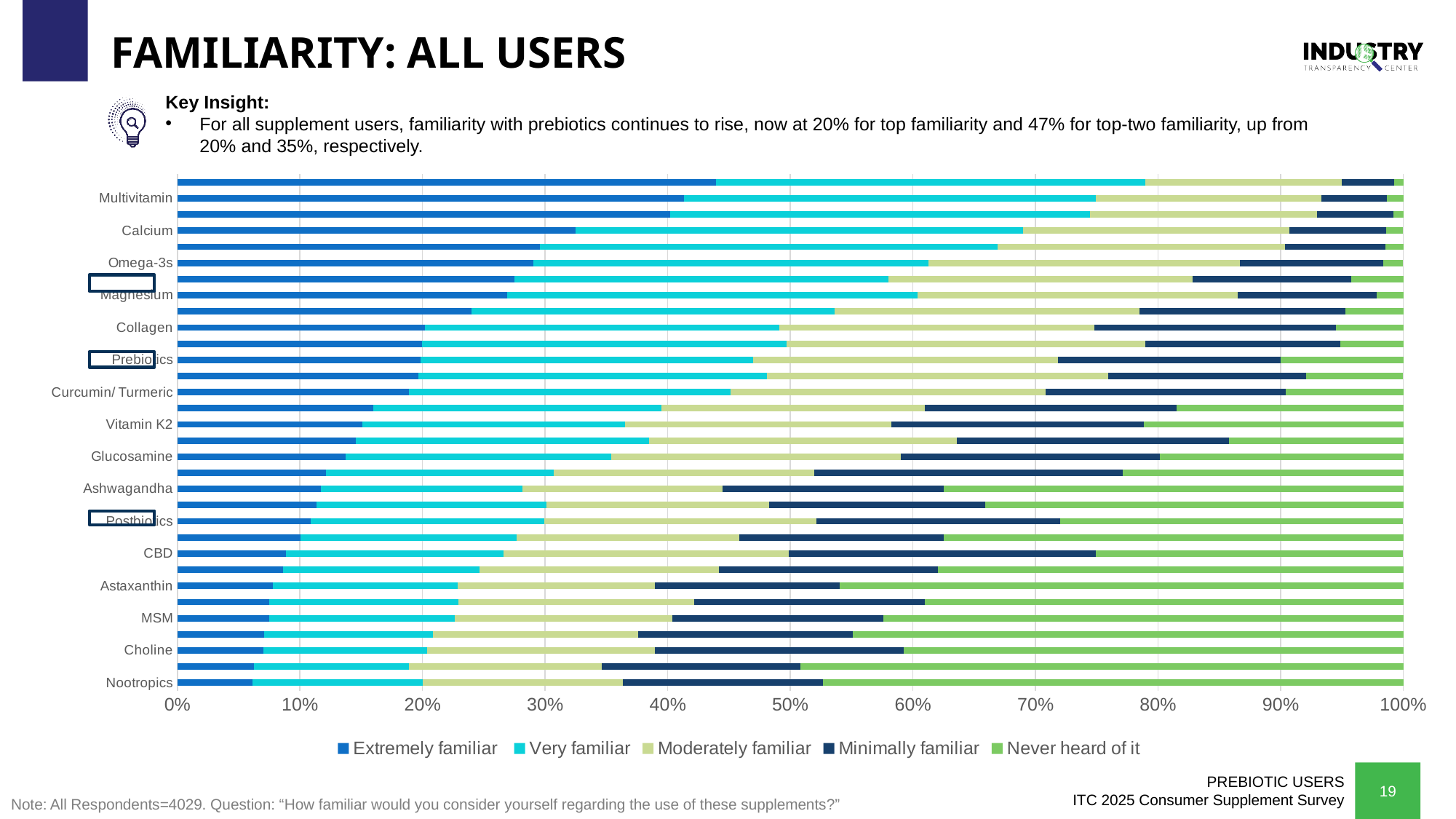
Which supplement has the lowest 'Extremely familiar' share? Nootropics Is the 'Extremely familiar' value for Prebiotics greater or less than 30%? less Which has a larger 'Never heard of it' share, Nootropics or Multivitamin? Nootropics What kind of chart is shown on the slide? Stacked bar chart Moving down the chart from Multivitamin to Nootropics, does the 'Extremely familiar' share rise or fall? Fall What is the title of the slide containing the chart? FAMILIARITY: ALL USERS Is the 'Extremely familiar' value for Multivitamin greater or less than 30%? greater Is the 'Extremely familiar' value for Nootropics greater or less than 10%? less Which has a larger 'Extremely familiar' share, Multivitamin or Nootropics? Multivitamin How many series does the chart legend list? 5 What is the last entry listed in the chart legend? Never heard of it